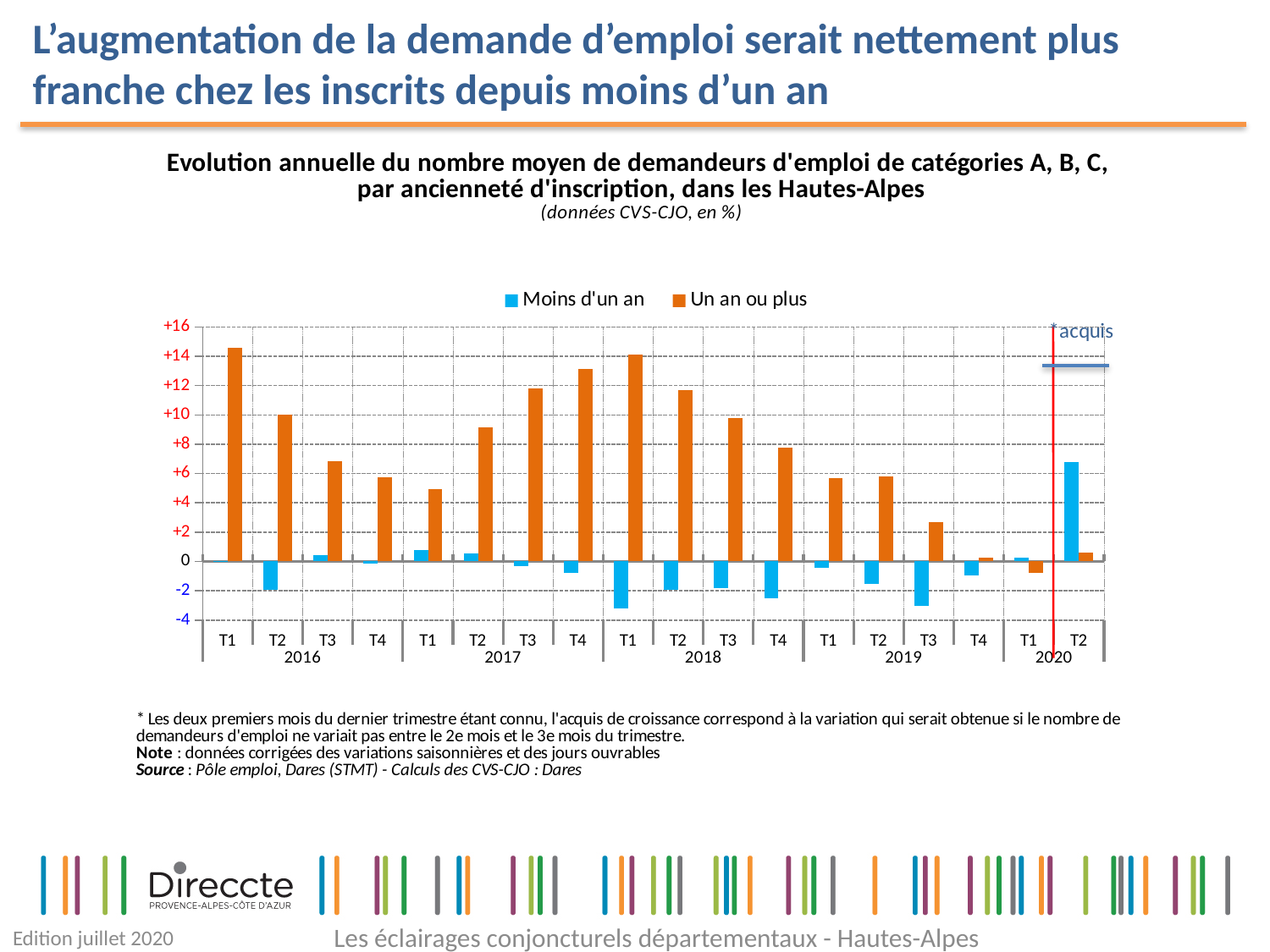
What kind of chart is shown on the slide? bar chart Do the values for 'Un an ou plus' rise or fall from T1 2018 to T4 2019? fall Is the value for 'Moins d'un an' in T2 2020 greater or less than +6? greater For 'Un an ou plus', which is larger: T2 2016 or T3 2016? T2 2016 Is the value for 'Moins d'un an' in T1 2018 greater or less than -2? less In T2 2020, which series has the larger value: 'Moins d'un an' or 'Un an ou plus'? Moins d'un an In which quarter is the value for 'Moins d'un an' highest? T2 2020 Is the value for 'Un an ou plus' in T1 2017 greater or less than +6? less Which series is shown in orange? Un an ou plus How many quarters are plotted along the x axis? 18 How many series does the legend list? 2